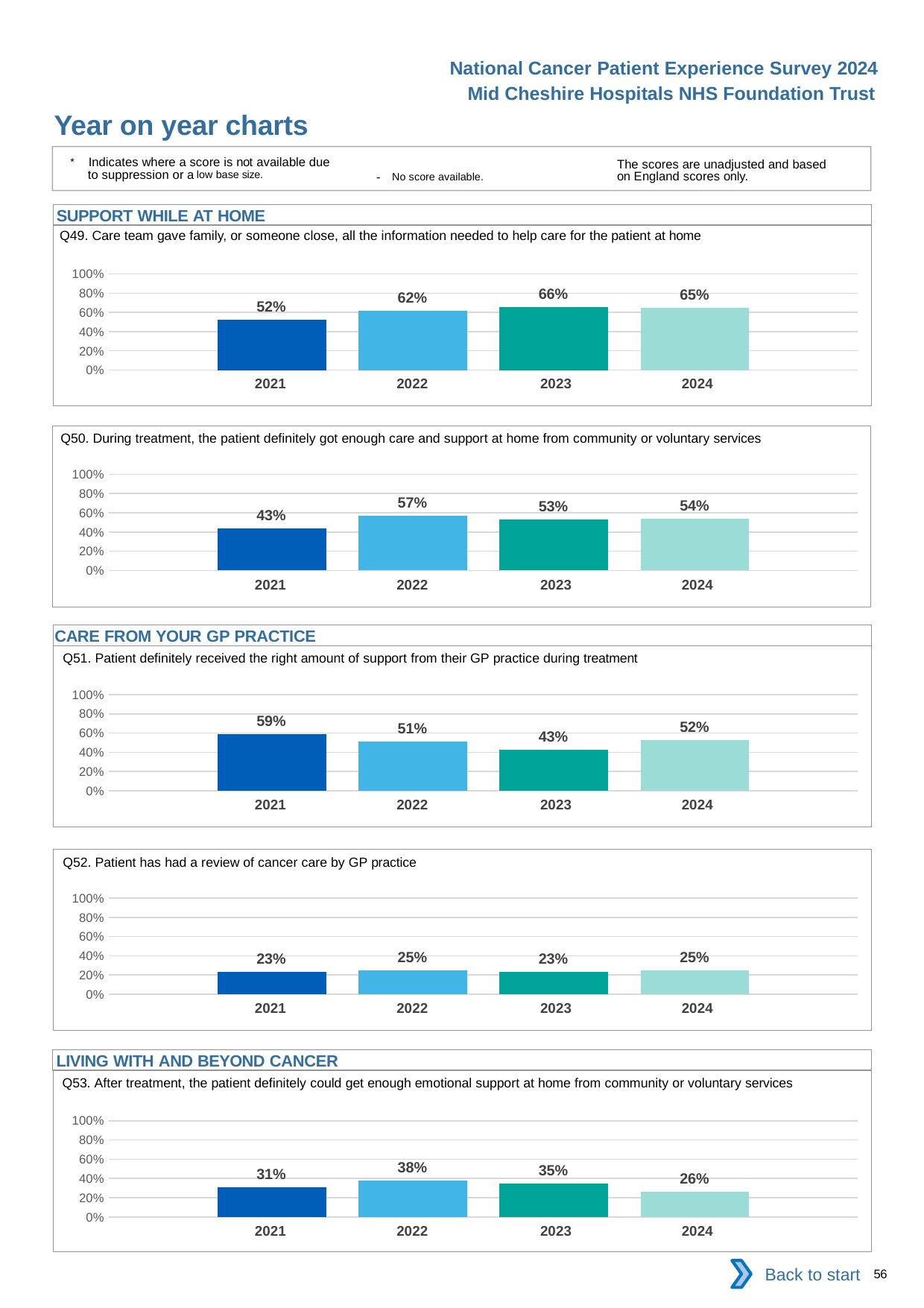
What kind of chart is the Q53 chart? Bar chart In the Q51 chart, is the value for 2024 larger than the value for 2023? Yes In the Q50 chart, what is the difference between the 2022 and 2021 values? 14% In the Q51 chart, which year has the highest value? 2021 In the Q49 chart, do the values rise or fall from 2021 to 2023? Rise In the Q52 chart, what is the value for 2024? 25% In the Q52 chart, how many years are plotted? 4 In the Q53 chart, what is the difference between the 2022 and 2024 values? 12% In the Q53 chart, what is the value for 2024? 26% In the Q50 chart, what is the value for 2022? 57% In the Q49 chart, which year has the lowest value? 2021 In the Q49 chart, what is the value for 2023? 66%